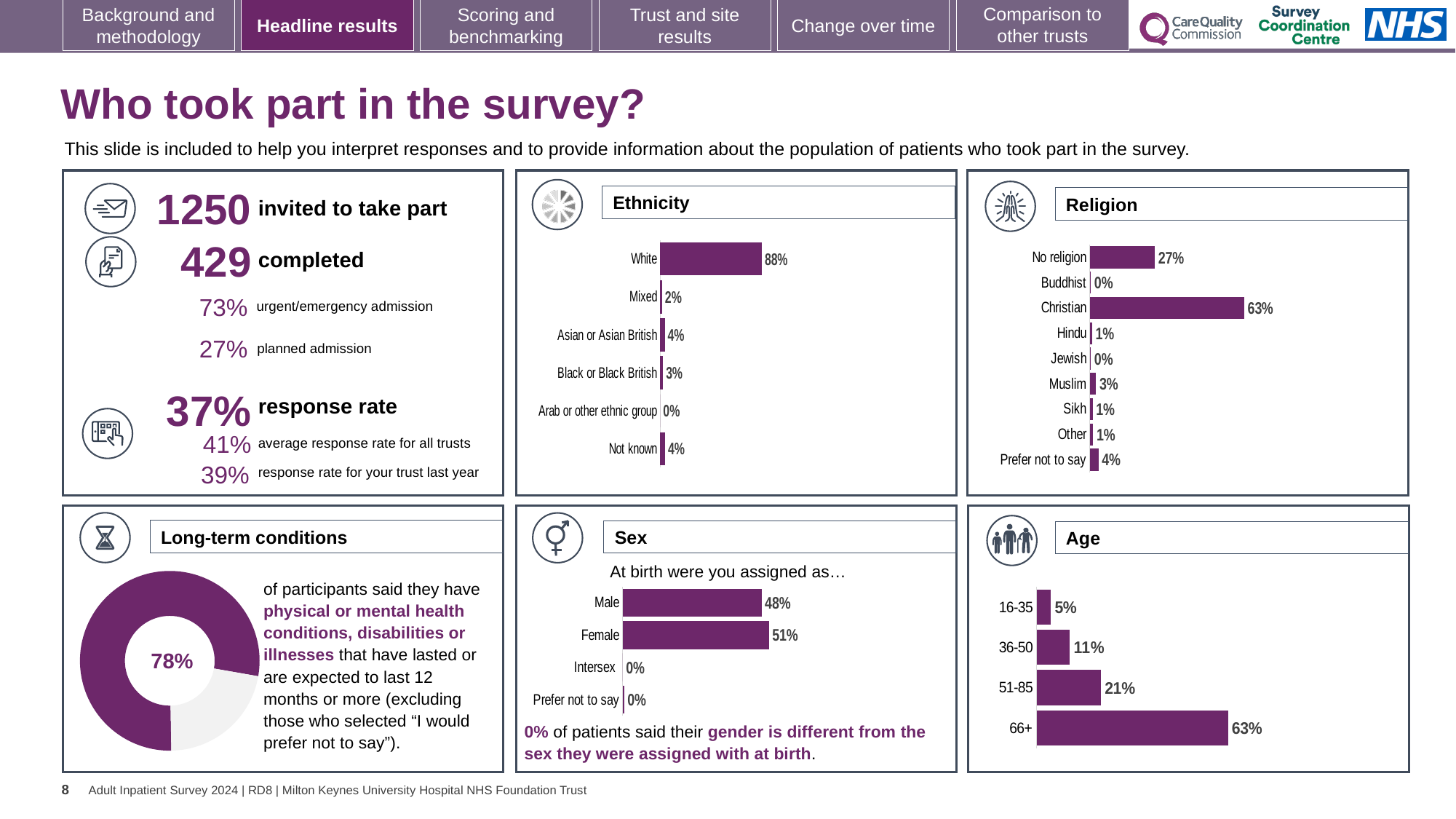
In the Age chart, what percentage of respondents are aged 66+? 63% In the Religion chart, what is the difference between the Christian and No religion values? 36% In the Sex chart, what percentage of respondents are Male? 48% In the Ethnicity chart, what percentage of respondents are White? 88% In the Religion chart, what percentage of respondents are Christian? 63% In the Sex chart, which is larger, Male or Female? Female In the Religion chart, how many categories are shown? 9 In the Ethnicity chart, which category has the highest value? White In the Age chart, do the values rise or fall as age increases from 16-35 to 66+? rise What kind of chart is the Long-term conditions chart? doughnut chart In the Ethnicity chart, how many categories are shown? 6 In the Age chart, what is the difference between the 51-85 and 36-50 values? 10%